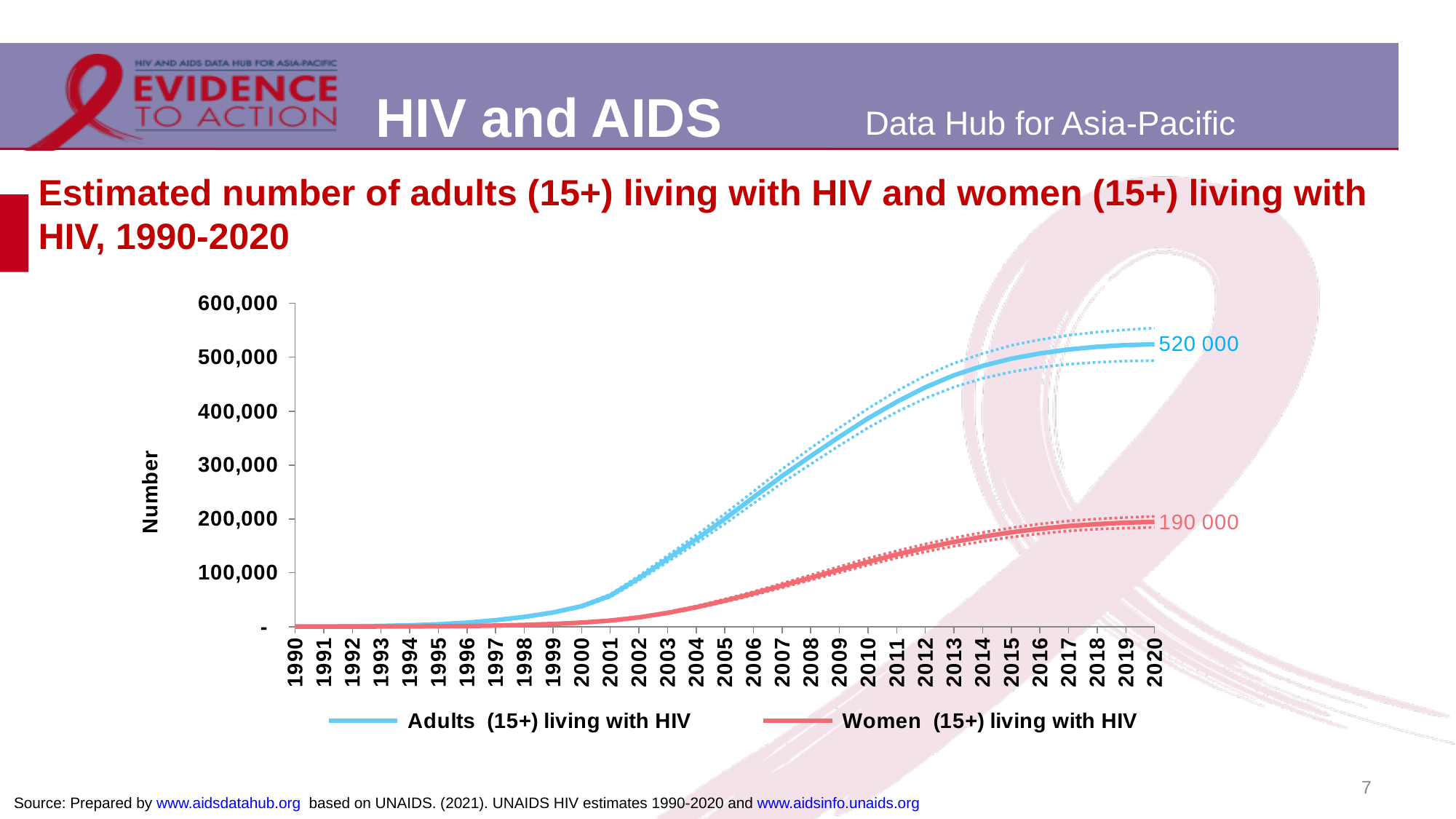
In 2020, which series has the larger value: Adults (15+) living with HIV or Women (15+) living with HIV? Adults (15+) living with HIV What kind of chart is shown on the slide? Line chart Is the value for Women (15+) living with HIV in 2005 greater or less than 100,000? less Is the value for Adults (15+) living with HIV in 2000 greater or less than 100,000? less Does the number of adults (15+) living with HIV rise or fall from 1990 to 2020? Rise What is the title of the vertical axis? Number How many years are shown on the x axis of the chart? 31 What is the estimated number of adults (15+) living with HIV in 2020? 520 000 How many series does the legend list? 2 Is the value for Adults (15+) living with HIV in 2015 greater or less than 400,000? greater What is the estimated number of women (15+) living with HIV in 2020? 190 000 What is the difference between the number of adults (15+) and women (15+) living with HIV in 2020? 330 000